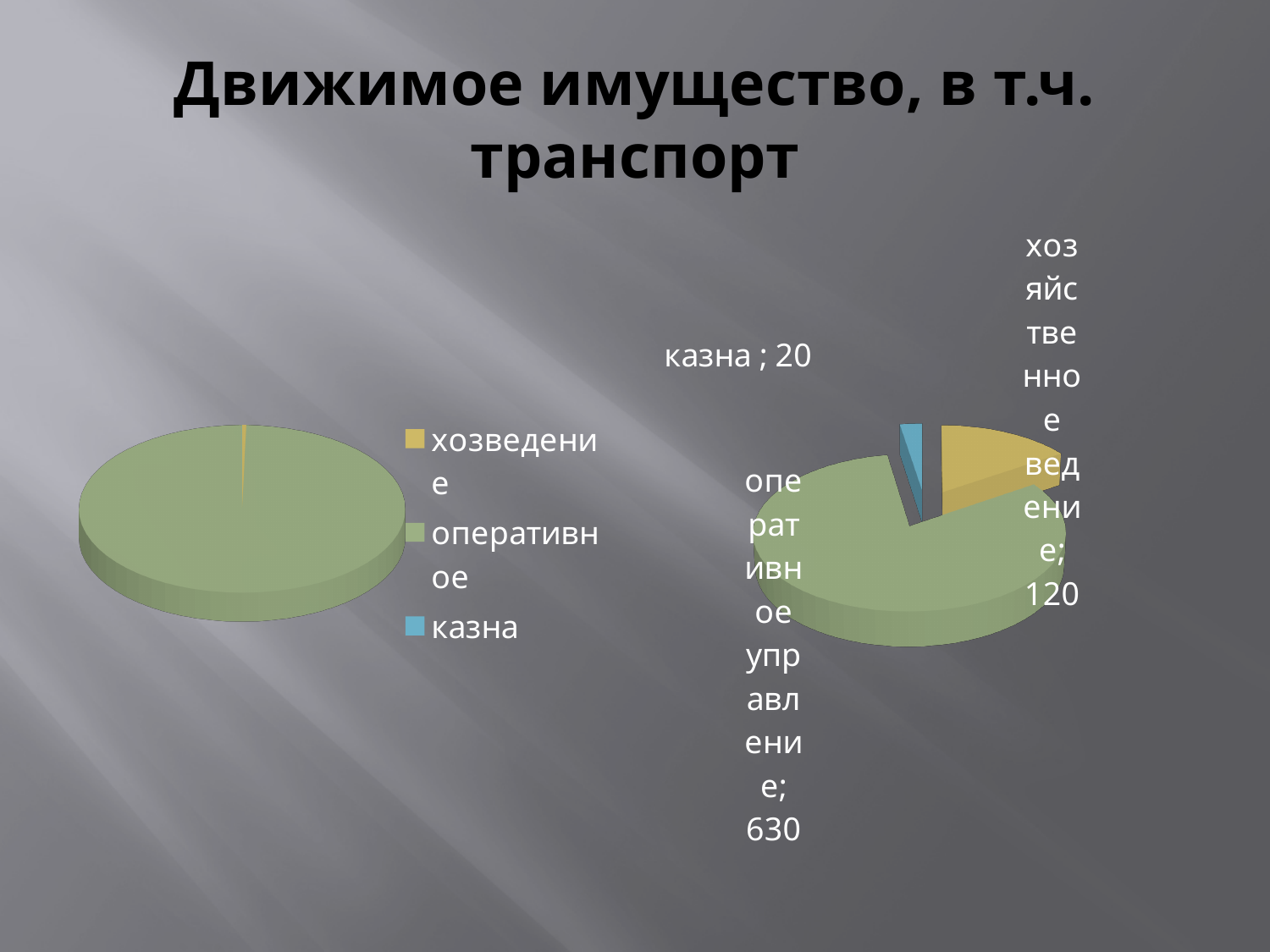
What type of chart is the left chart on the slide? pie chart In the right pie chart, what is the total of all three slices? 770 How many slices does the right pie chart have? 3 How many entries does the legend of the left pie chart list? 3 In the right pie chart, what is the value for казна? 20 In the right pie chart, what is the value for оперативное управление? 630 In the right pie chart, which is larger: хозяйственное ведение or казна? хозяйственное ведение In the right pie chart, what is the difference between оперативное управление and хозяйственное ведение? 510 In the right pie chart, what is the value for хозяйственное ведение? 120 In the right pie chart, which category has the largest value? оперативное управление In the right pie chart, which category has the smallest value? казна In the right pie chart, what is the difference between хозяйственное ведение and казна? 100